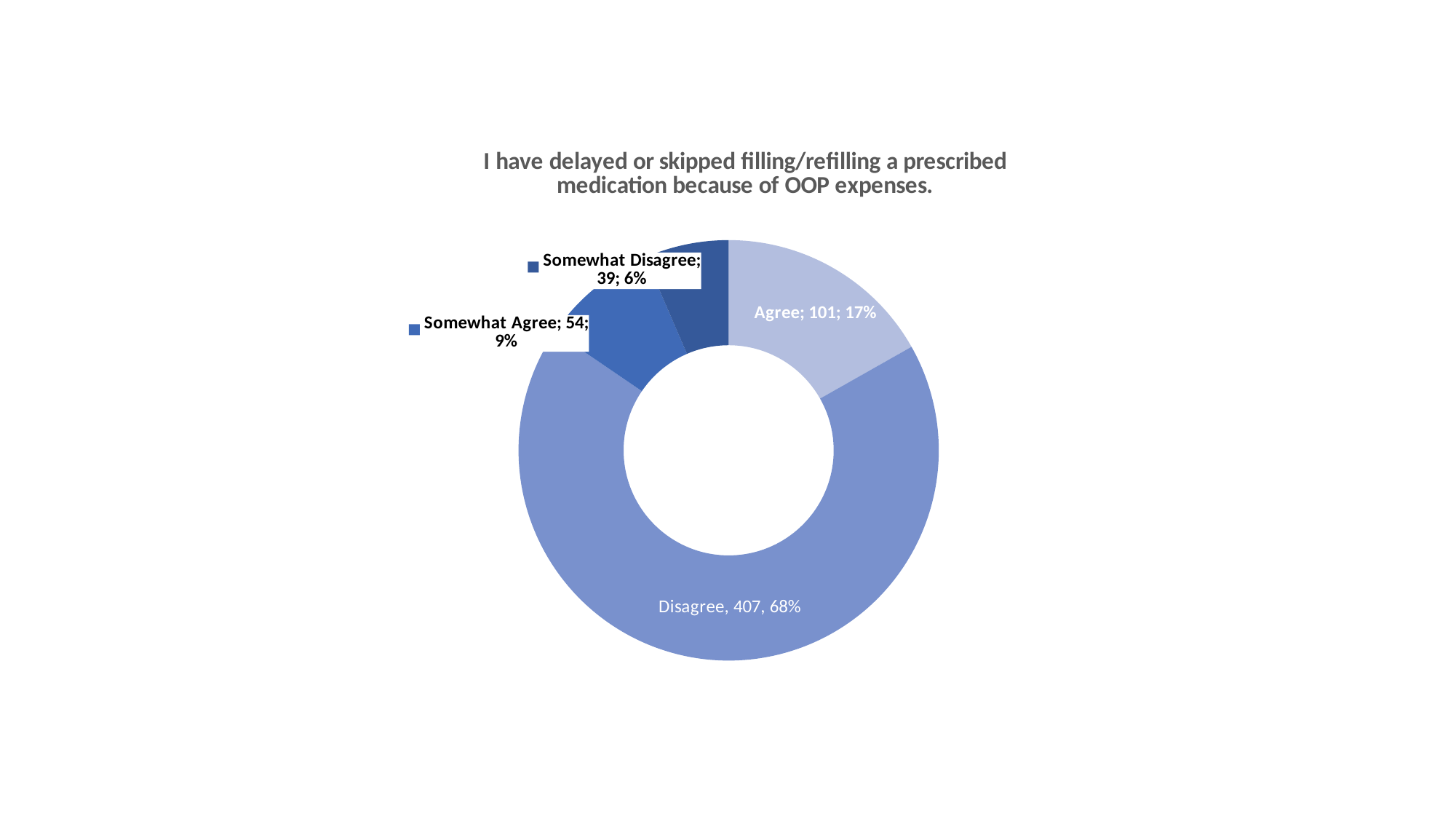
What percentage of respondents chose Agree? 17% What kind of chart is shown on the slide? Doughnut (pie) chart Which category has the smallest share? Somewhat Disagree What percentage share does Somewhat Disagree have? 6% What is the difference in count between Agree and Somewhat Agree? 47 How many categories are shown in the chart? 4 How many respondents chose Somewhat Agree? 54 What is the title of the chart? I have delayed or skipped filling/refilling a prescribed medication because of OOP expenses. How many respondents chose Disagree? 407 Which has more respondents, Somewhat Agree or Somewhat Disagree? Somewhat Agree What is the total number of respondents across all four categories? 601 Which category has the largest share? Disagree